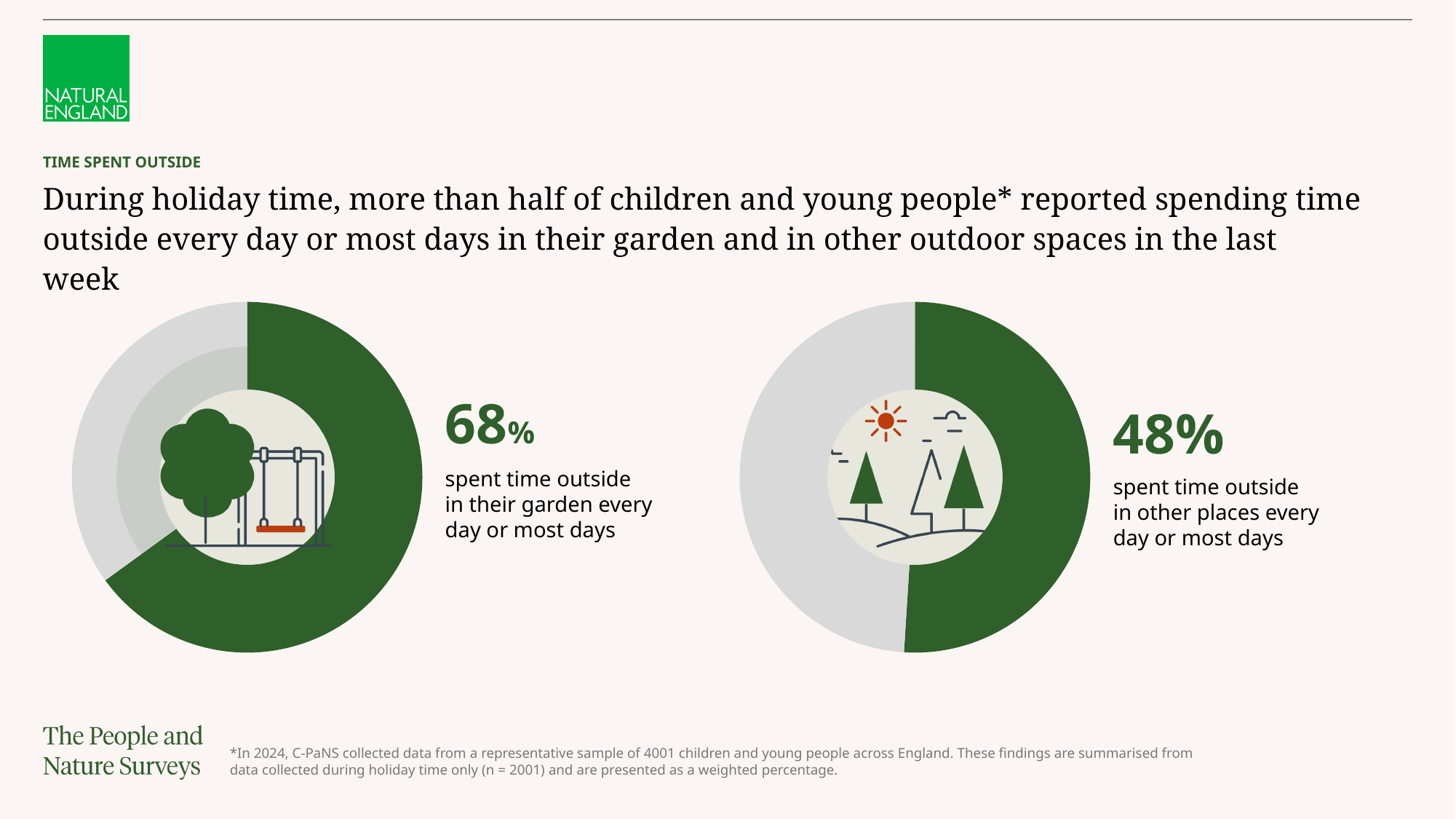
How many donut charts are shown on the slide? 2 What kind of chart is used on the left of the slide to show the 68% figure? Donut (pie) chart Which of the two donut charts has the smaller green segment? The right chart (other places, 48%) What is the section heading shown above the slide's main statement? TIME SPENT OUTSIDE What colour is used for the filled segment in both donut charts? Dark green Which is larger: the percentage who spent time outside in their garden every day or most days, or the percentage who spent time outside in other places every day or most days? In their garden (68%) What is the difference in percentage points between the garden figure (68%) and the other places figure (48%)? 20 percentage points On the right donut chart, what percentage of children and young people spent time outside in other places every day or most days? 48% Which of the two donut charts has the larger green segment? The left chart (garden, 68%) On the left donut chart, what percentage of children and young people spent time outside in their garden every day or most days? 68%